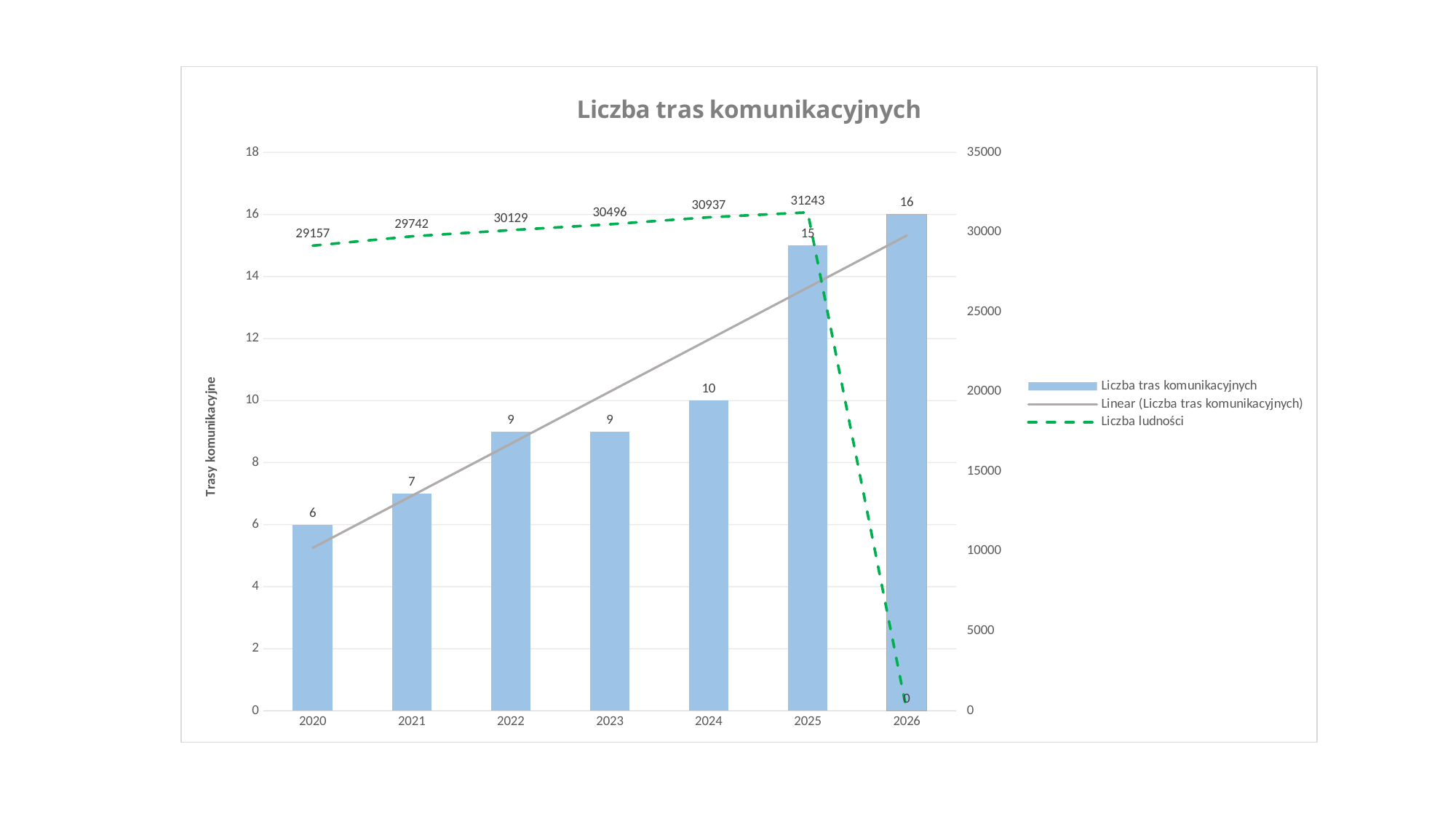
How many entries does the legend list? 3 Which year has the lowest value of Liczba tras komunikacyjnych? 2020 What is the value of Liczba tras komunikacyjnych for 2025? 15 What is the title of the chart? Liczba tras komunikacyjnych What is the difference between the Liczba ludności values for 2021 and 2020? 585 Which is larger, the Liczba tras komunikacyjnych value for 2021 or for 2024? 2024 What is the value of Liczba tras komunikacyjnych for 2020? 6 What is the value of Liczba ludności for 2025? 31243 How many years are shown on the x axis? 7 What is the difference between the Liczba tras komunikacyjnych values for 2025 and 2024? 5 Which year has the highest value of Liczba tras komunikacyjnych? 2026 What is the value of Liczba ludności for 2022? 30129